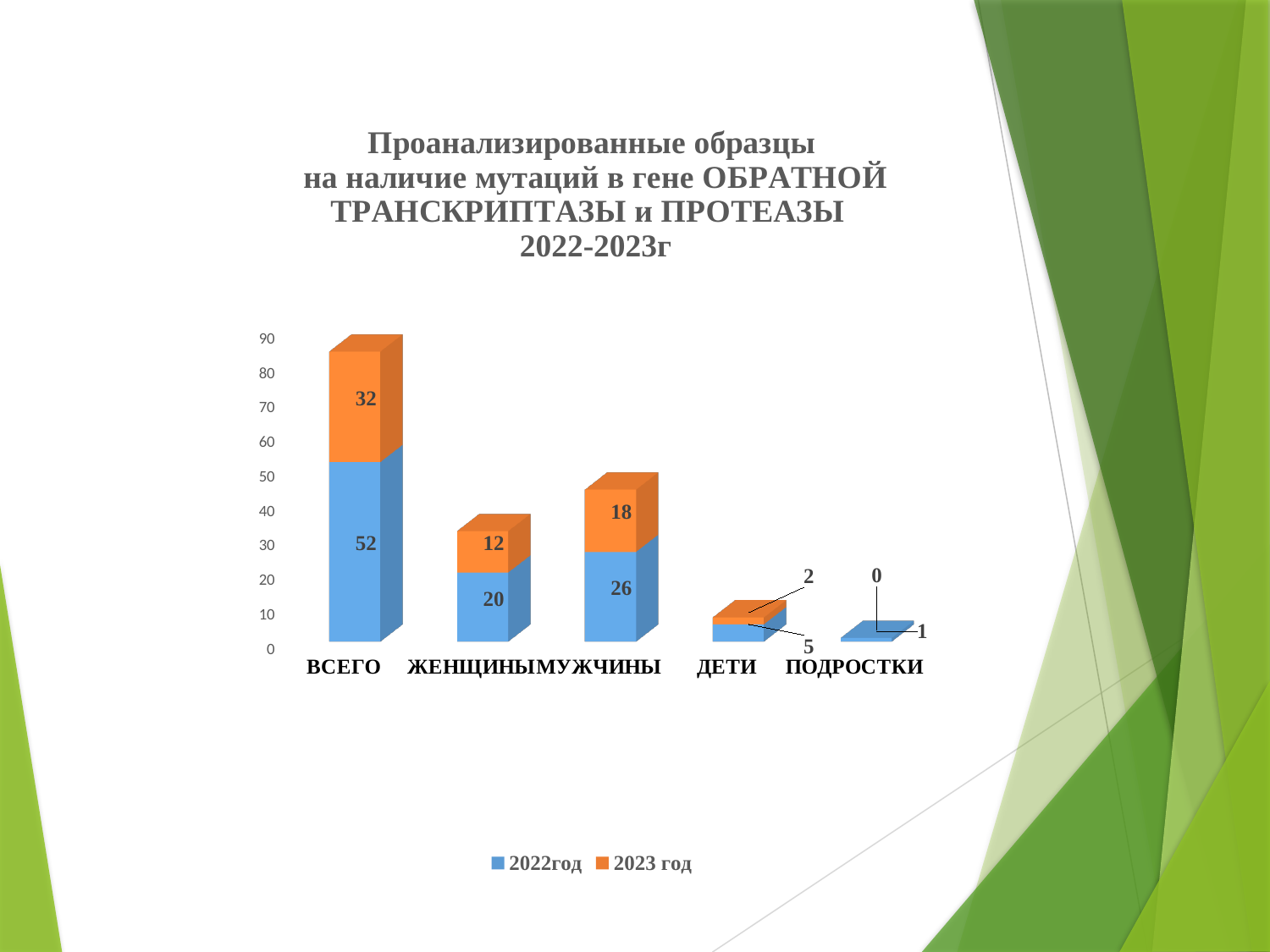
What is the value for МУЖЧИНЫ in the 2023 год series? 18 What is the value for ВСЕГО in the 2022год series? 52 Which category has the lowest value in the 2022год series? ПОДРОСТКИ Which category has the highest value in the 2023 год series? ВСЕГО What is the total of the stacked bar for ЖЕНЩИНЫ? 32 What kind of chart is shown on the slide? Stacked bar chart What is the difference between the 2022год values for МУЖЧИНЫ and ЖЕНЩИНЫ? 6 How many categories are shown on the x axis? 5 What is the value for ДЕТИ in the 2022год series? 5 Which is larger: the 2023 год value for ЖЕНЩИНЫ or the 2023 год value for МУЖЧИНЫ? МУЖЧИНЫ How many series does the legend list? 2 What is the value for ПОДРОСТКИ in the 2023 год series? 0